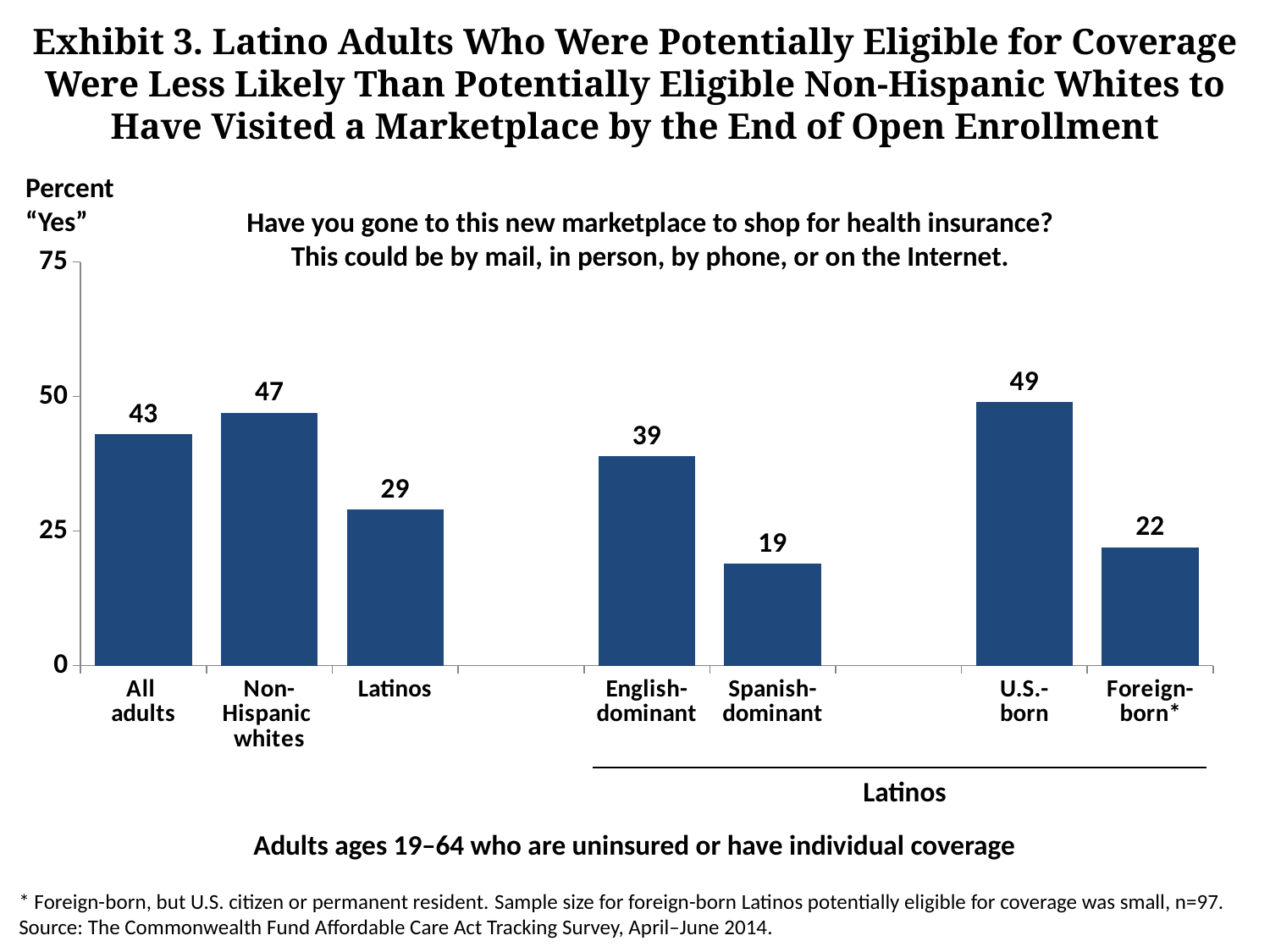
How many bars are shown in the chart? 7 Which category has the lowest value? Spanish-dominant What is the value for Spanish-dominant Latinos? 19 What is the value for Non-Hispanic whites? 47 Which category has the highest value? U.S.-born What is the maximum value shown on the vertical axis? 75 What is the difference between English-dominant and Spanish-dominant Latinos? 20 What is the value for foreign-born Latinos? 22 What percentage of all adults said they had gone to the new marketplace? 43 Which is larger, the value for U.S.-born or for foreign-born Latinos? U.S.-born What type of chart is shown on the slide? Bar chart What is the difference between the values for Non-Hispanic whites and Latinos? 18